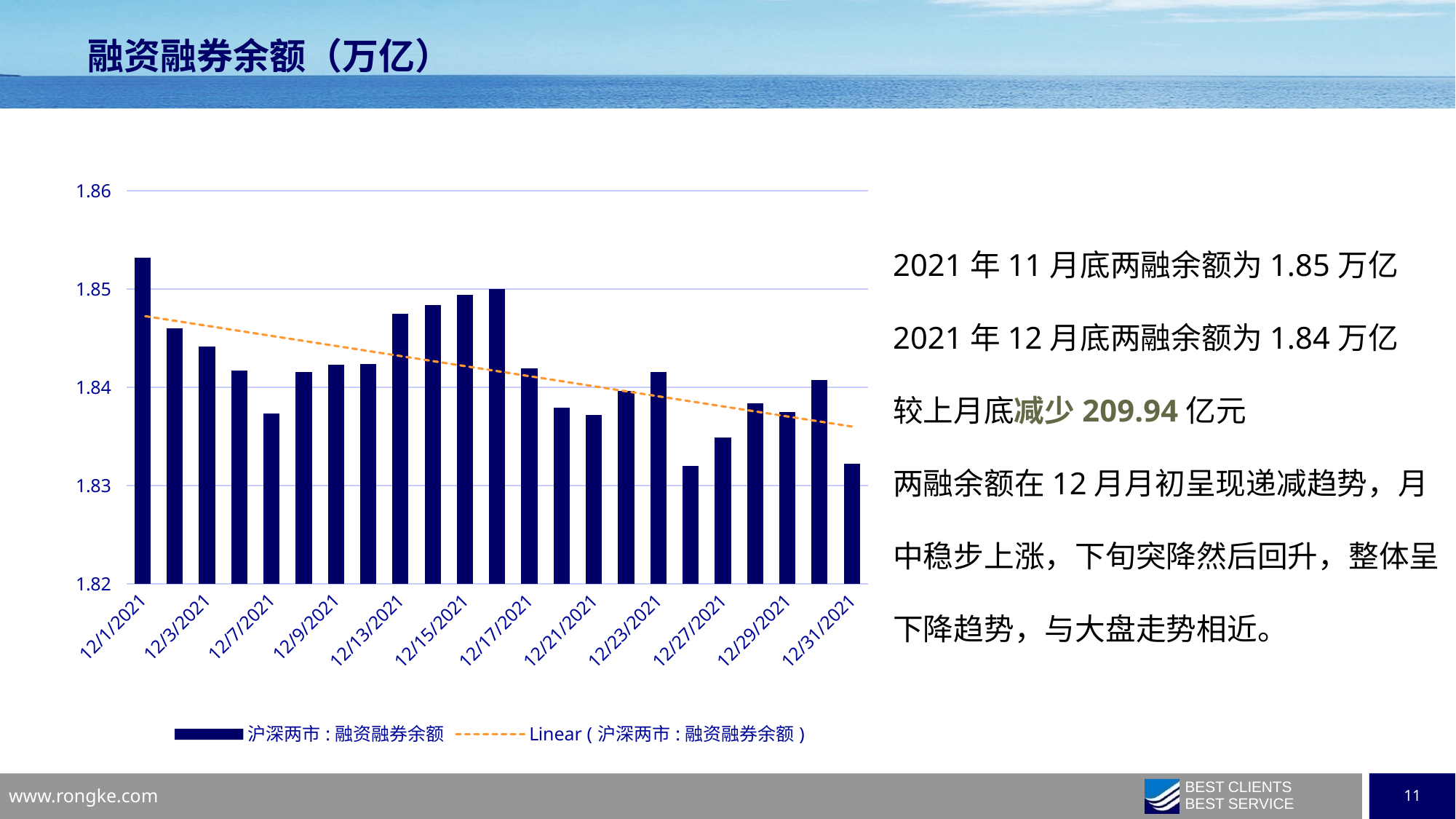
Which is larger, the value for 12/1/2021 or the value for 12/31/2021? 12/1/2021 Which is larger, the value for 12/15/2021 or the value for 12/7/2021? 12/15/2021 Is the value for 12/15/2021 greater or less than 1.84? greater According to the dashed linear trend line, do the values overall rise or fall across December 2021? fall What kind of chart is shown on the slide? bar chart How many bars are plotted in the chart? 23 What colour is the dashed linear trend line in the chart? orange Is the value for 12/1/2021 greater or less than 1.85? greater Is the value for 12/7/2021 greater or less than 1.84? less Which date has the highest bar in the chart? 12/1/2021 How many entries does the chart legend list? 2